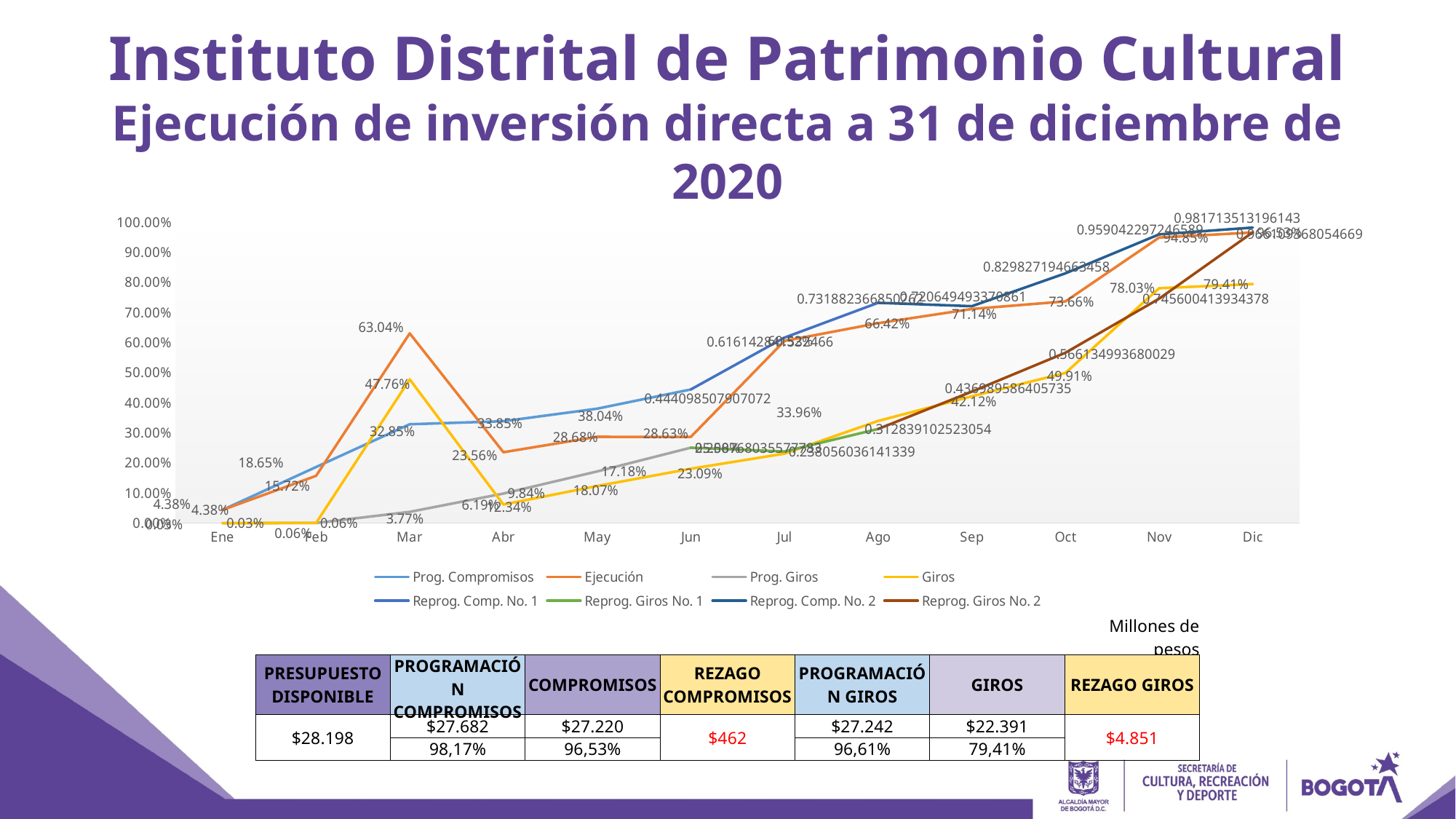
What is the Giros value for Dic? 79.41% What is the Ejecución value for Nov? 94.85% In Mar, which is larger: the Ejecución value or the Giros value? Ejecución How many months are plotted along the x axis of the chart? 12 What kind of chart is shown on the slide? line chart What is the Prog. Giros value for Mar? 3.77% Do the Giros values rise or fall from Sep to Dic? rise Is the Ejecución value for Dic greater or less than 90%? greater What is the Ejecución value for Mar? 63.04% How many series does the chart legend list? 8 Between Ene and Jun, in which month is the Ejecución value highest? Mar What is the difference between the Ejecución values for Mar and Abr? 39.48 percentage points